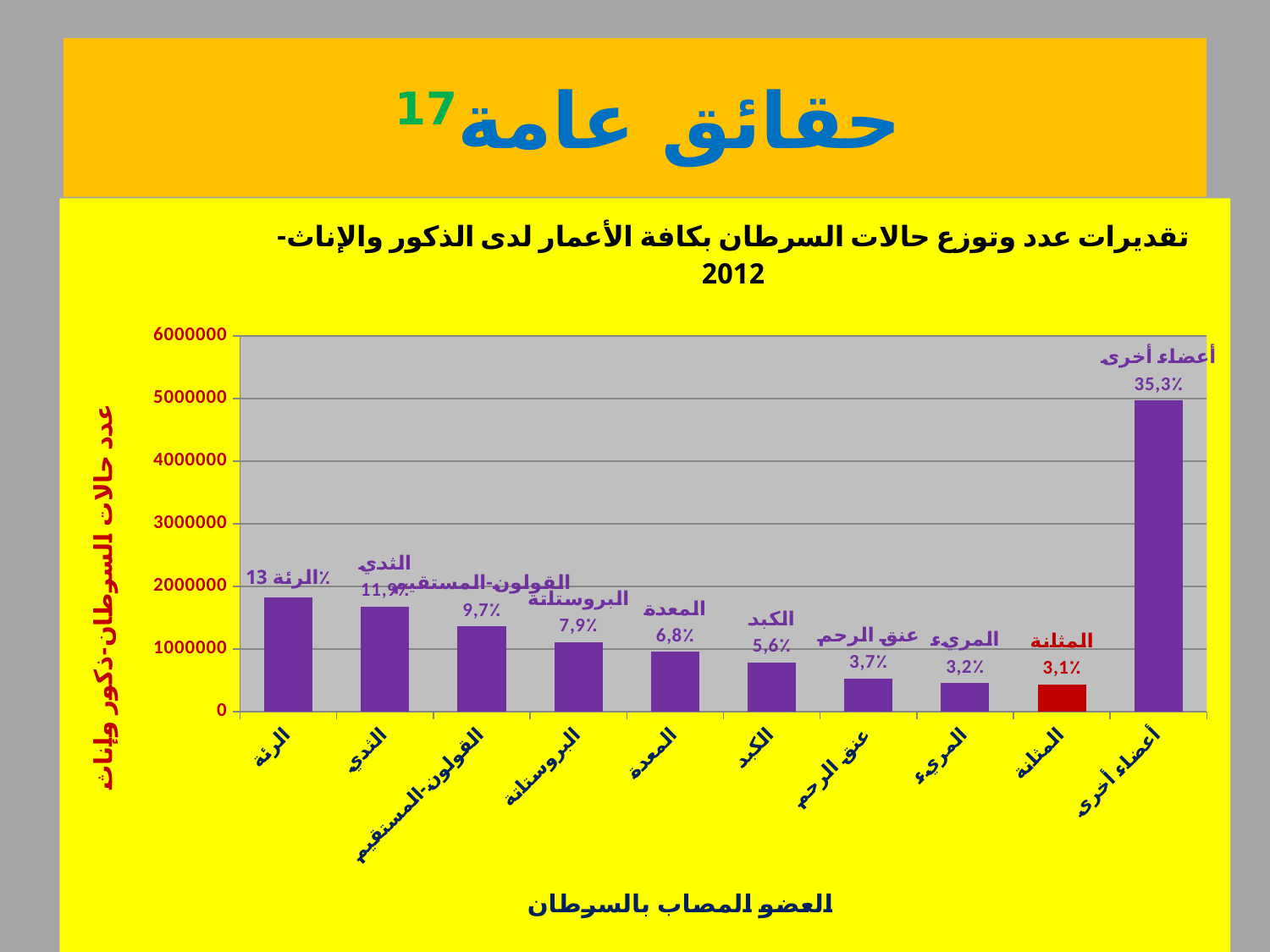
Which has a larger value, المعدة (stomach) or الكبد (liver)? المعدة Is the value for أعضاء أخرى (other organs) greater or less than 4000000? greater What percentage is labelled for أعضاء أخرى (other organs) in the chart? 35,3% What kind of chart is shown on the slide? bar chart What percentage is labelled for المثانة (bladder) in the chart? 3,1% Is the value for الرئة (lung) greater or less than 1000000? greater Which category has the highest value in the chart? أعضاء أخرى What is the difference in percentage points between الرئة (13%) and الثدي (11,9%)? 1,1 Which category has the lowest labelled percentage in the chart? المثانة What percentage is labelled for الرئة (lung) in the chart? 13% How many categories (organs) are shown on the x axis of the chart? 10 Which category's bar is coloured red instead of purple? المثانة